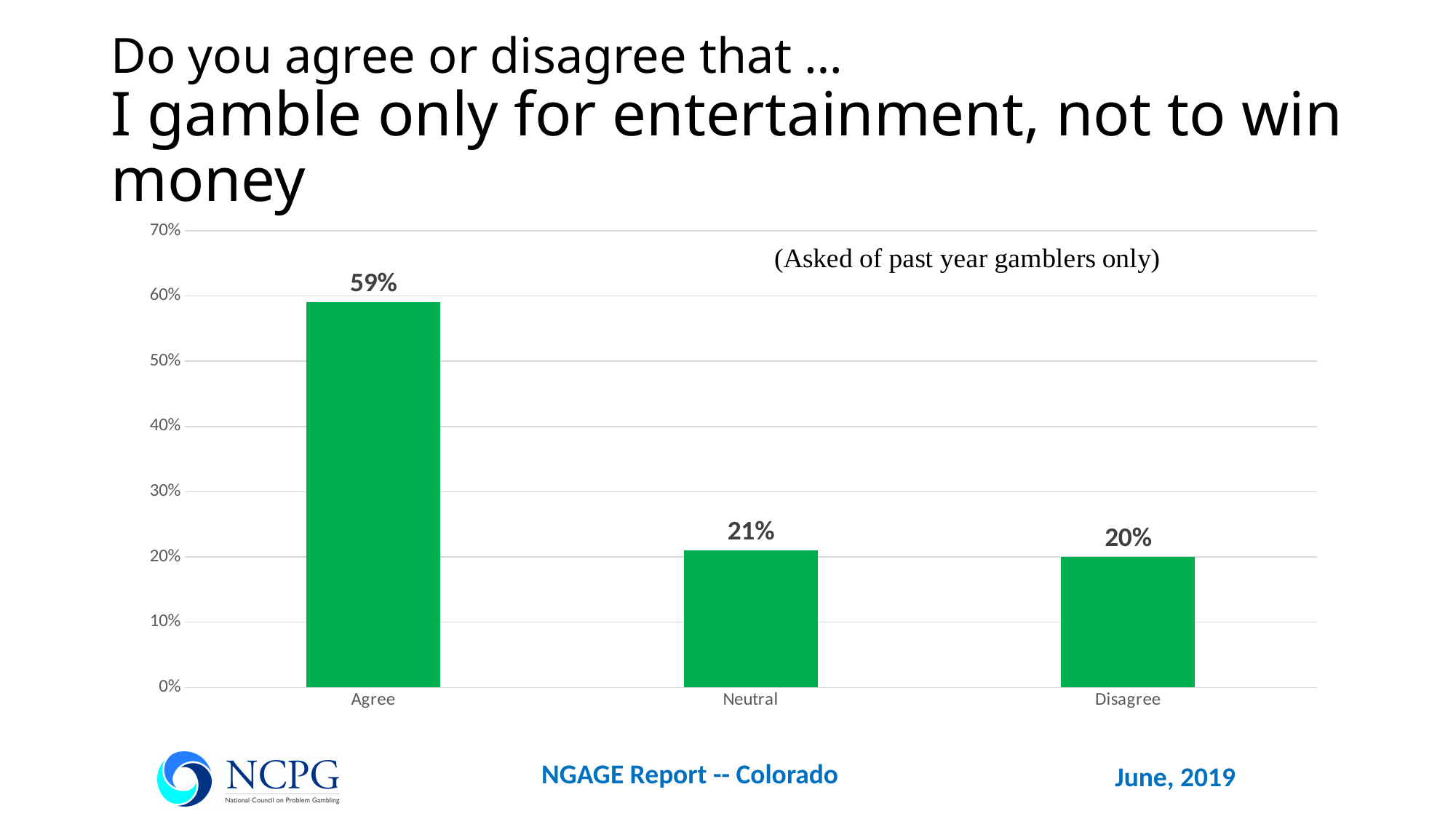
What kind of chart is shown on the slide? Bar chart What is the difference between the Neutral and Disagree percentages? 1% What is the difference between the Agree and Disagree percentages? 39% Which response category has the lowest value? Disagree Which is larger, the value for Agree or the value for Neutral? Agree Is the value for Agree greater or less than 50%? greater What percentage of respondents chose Agree? 59% What note appears inside the chart area about who was asked the question? (Asked of past year gamblers only) What percentage of respondents chose Neutral? 21% How many response categories are shown on the x axis? 3 What percentage of respondents chose Disagree? 20% Which response category has the highest value? Agree